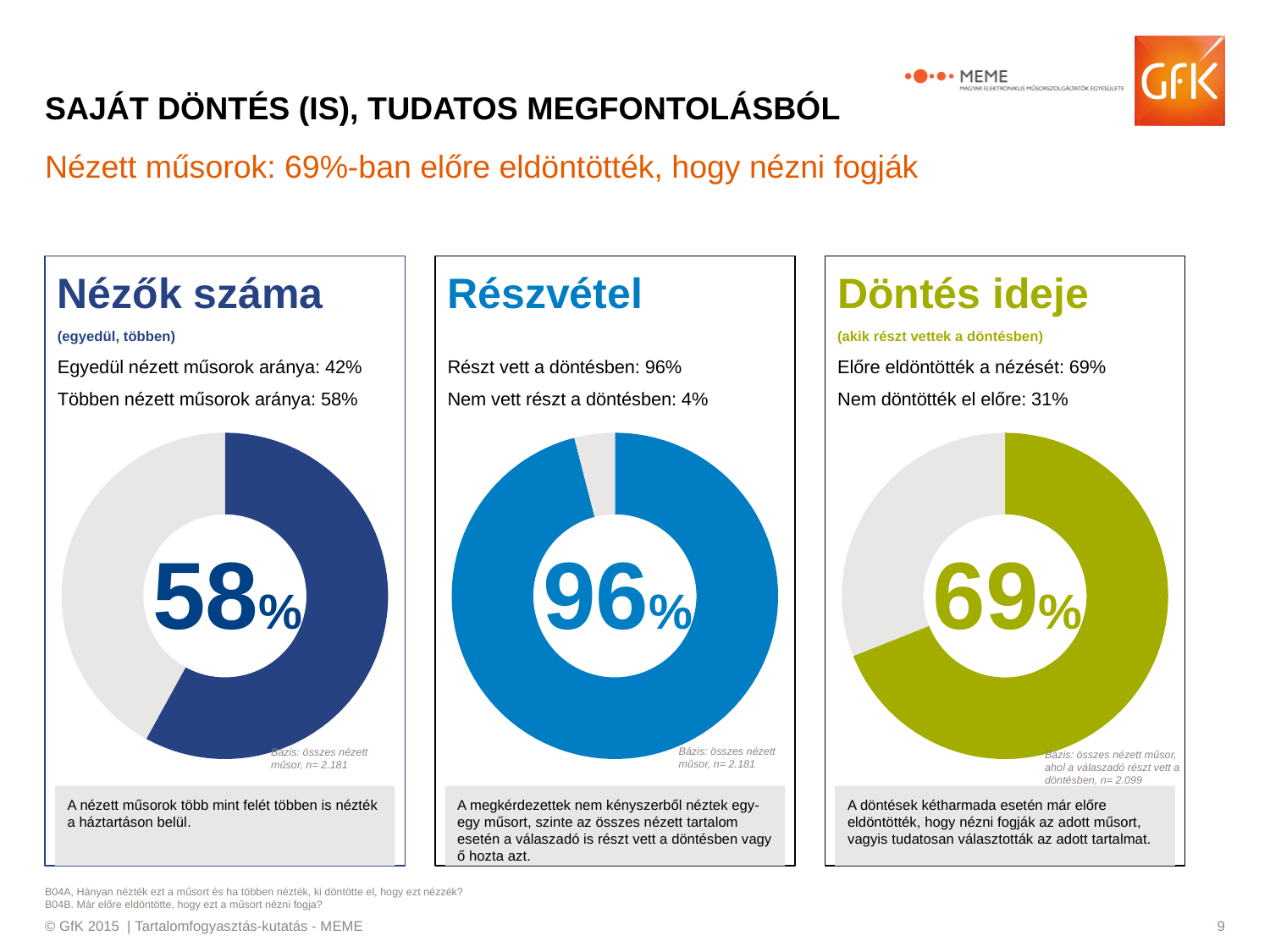
How many slices does the 'Döntés ideje' donut chart have? 2 In the 'Döntés ideje' chart, which is larger: the share that decided in advance or the share that did not? Decided in advance (Előre eldöntötték), 69% In the 'Részvétel' chart, which category is the smallest? Nem vett részt a döntésben (4%) In the 'Nézők száma' chart, what share of watched programmes were watched by several people (Többen nézett műsorok aránya)? 58% In the 'Részvétel' chart, what percentage did not take part in the decision (Nem vett részt a döntésben)? 4% What is the sample size (n) stated under the 'Döntés ideje' chart? n= 2.099 In the 'Döntés ideje' chart, what percentage decided in advance to watch (Előre eldöntötték a nézését)? 69% What kind of chart is used in the 'Részvétel' panel? Donut chart In the 'Részvétel' chart, what percentage took part in the decision (Részt vett a döntésben)? 96% In the 'Döntés ideje' chart, what percentage did not decide in advance (Nem döntötték el előre)? 31% In the 'Nézők száma' chart, what share of watched programmes were watched alone (Egyedül nézett műsorok aránya)? 42% In the 'Nézők száma' chart, what is the difference between the share watched by several people and the share watched alone? 16%